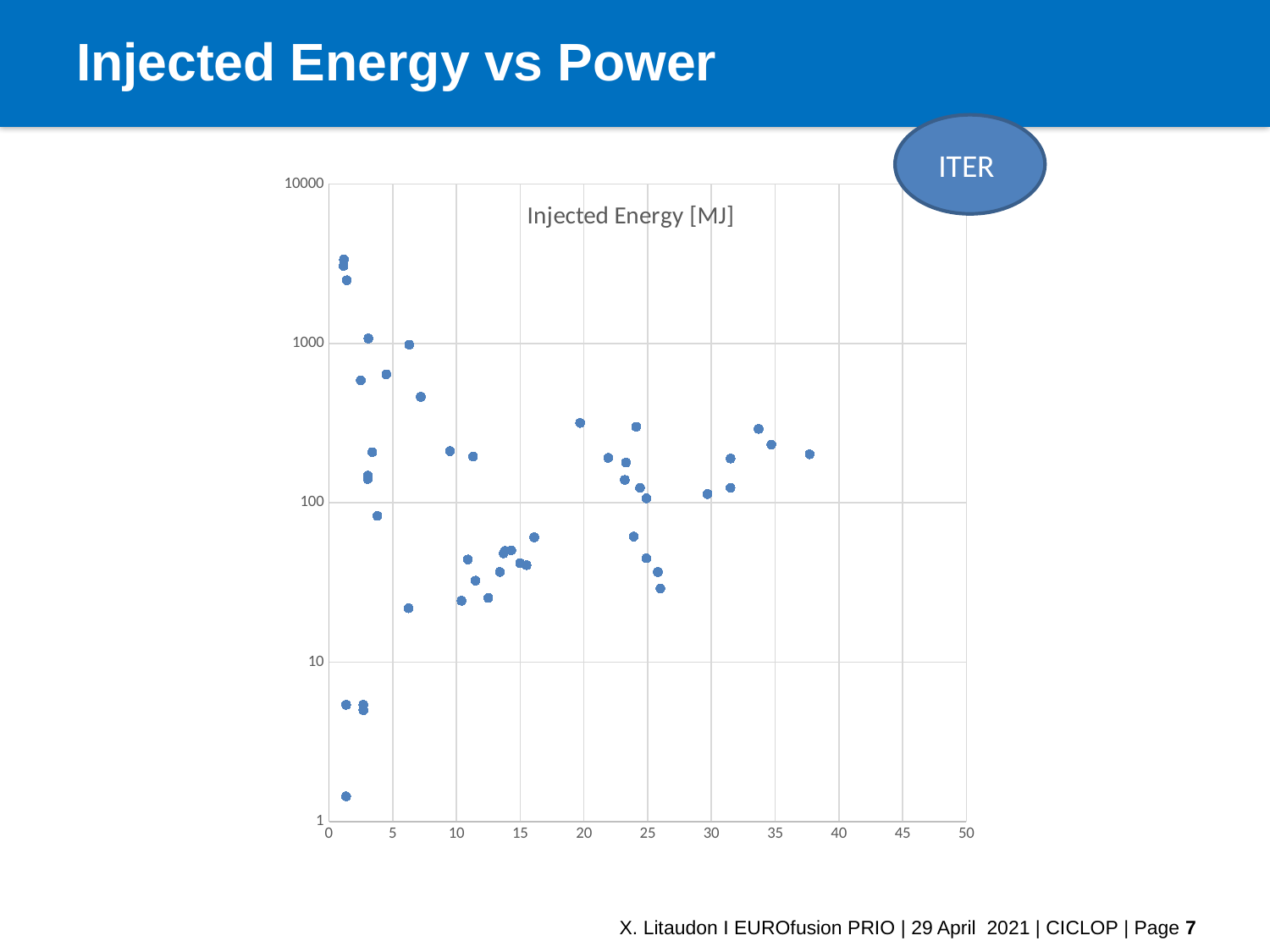
What kind of chart is shown on the slide? scatter chart Which is larger: the highest point near x = 1 or the highest point near x = 20? the highest point near x = 1 What is the highest value labelled on the x axis of the chart? 50 Are the y-axis tick labels spaced on a logarithmic scale (1, 10, 100, 1000, 10000) or a linear scale? logarithmic Do any plotted points in the chart lie beyond x = 40? No Is the lowest plotted point in the chart greater or less than 10? less What is the highest value labelled on the y axis of the chart? 10000 Is the point plotted furthest to the right (near x = 38) greater or less than 100? greater What is the title printed inside the chart's plot area? Injected Energy [MJ]